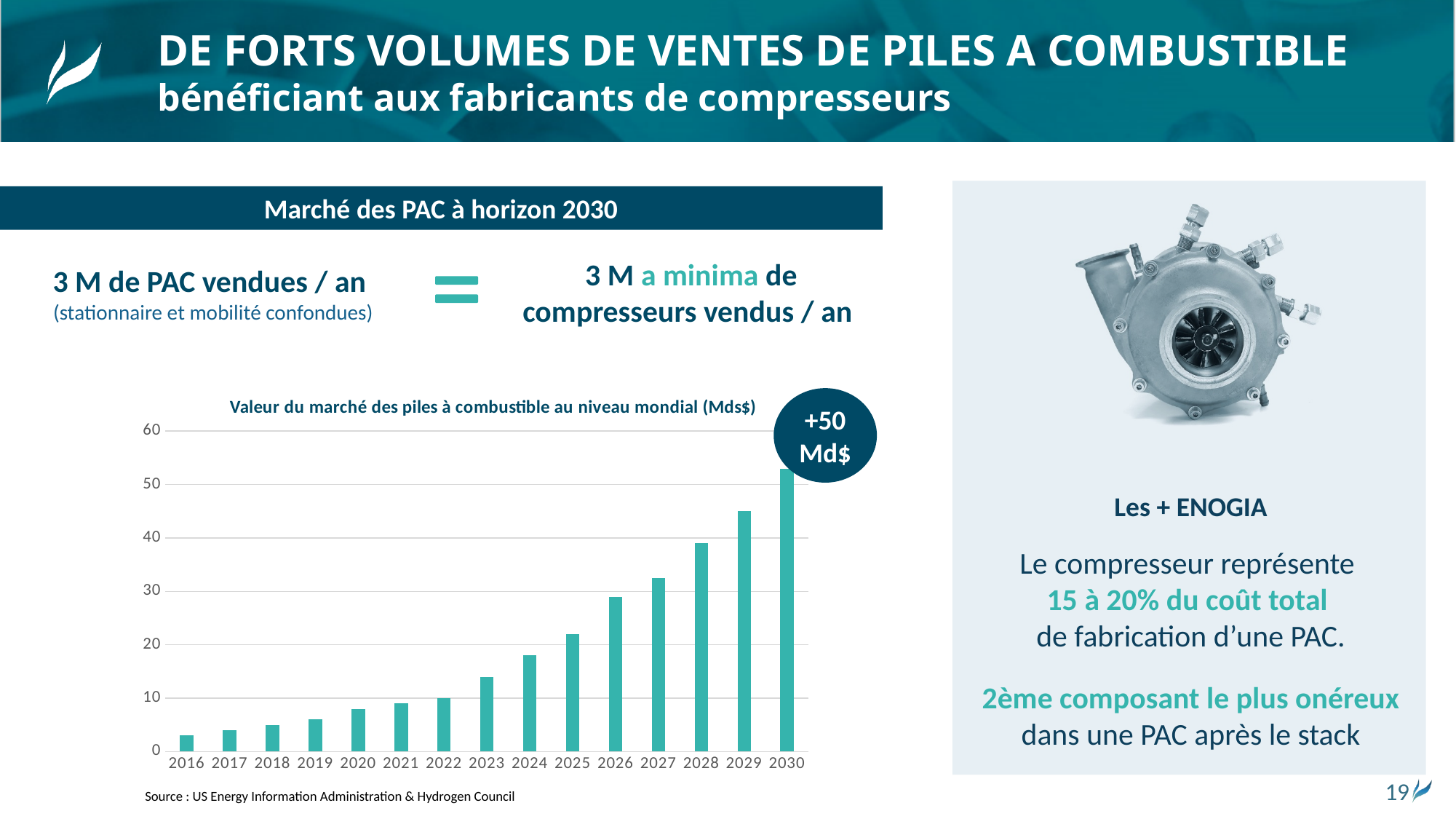
Is the value for 2030 greater or less than 50? greater What kind of chart is shown under the title 'Valeur du marché des piles à combustible au niveau mondial (Mds$)'? bar chart How many years are plotted on the x axis of the chart? 15 What is the title of the chart? Valeur du marché des piles à combustible au niveau mondial (Mds$) Which is larger, the value for 2025 or the value for 2027? 2027 Which year has the lowest value in the chart? 2016 Is the value for 2029 greater or less than 40? greater Which year has the highest value in the chart? 2030 Is the value for 2024 greater or less than 20? less Do the values rise or fall from 2016 to 2030? rise